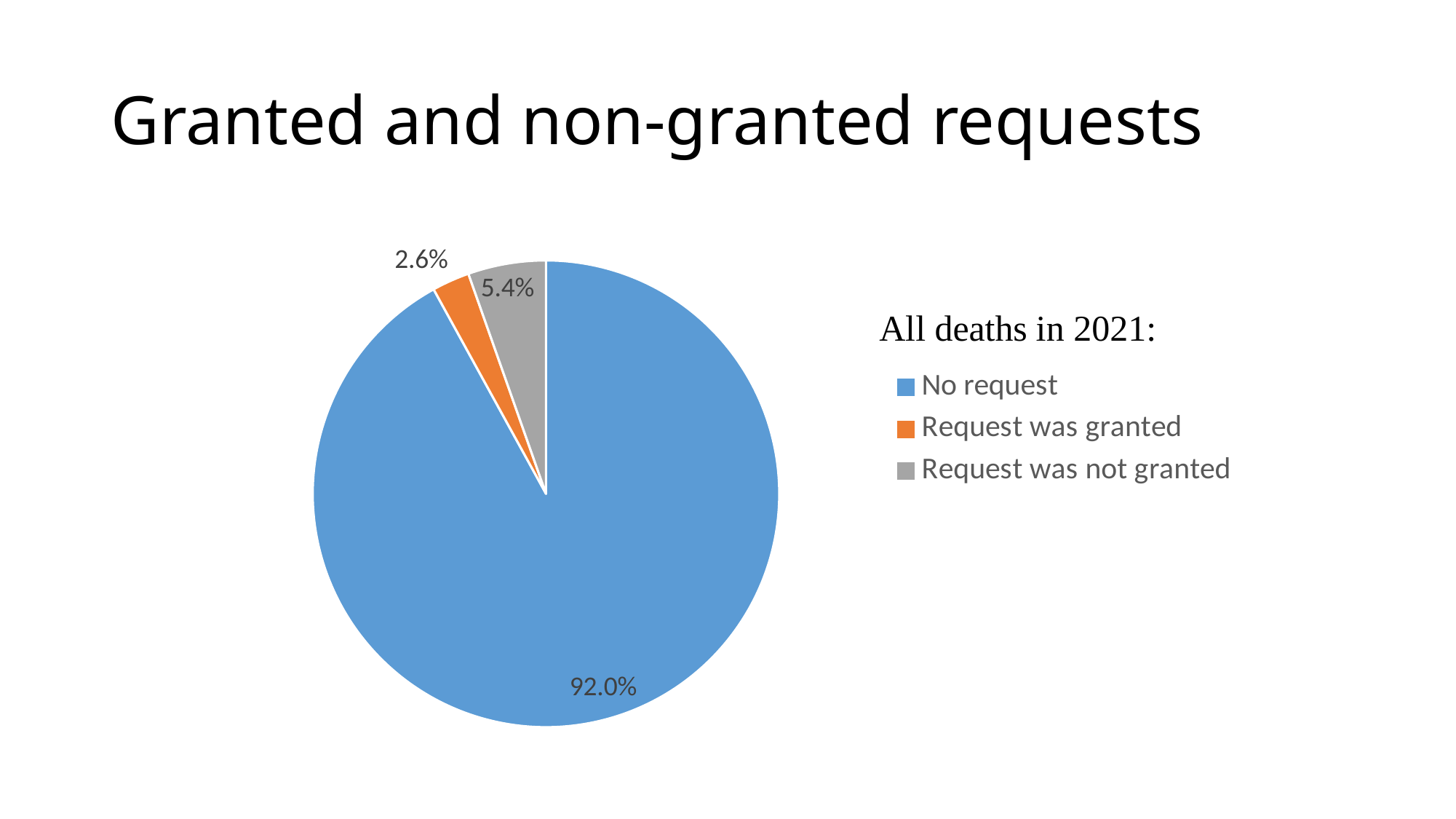
Which category has the largest slice of the pie? No request What is the title of the slide? Granted and non-granted requests What share of the pie is labelled 'Request was granted'? 2.6% What is the difference in percentage points between 'Request was not granted' and 'Request was granted'? 2.8 What colour is the slice for 'Request was granted'? Orange How many entries does the legend list? 3 What kind of chart is shown on the slide? Pie chart Which is larger: the slice for 'Request was granted' or the slice for 'Request was not granted'? Request was not granted Which category has the smallest slice of the pie? Request was granted What share of the pie is labelled 'No request'? 92.0% What share of the pie is labelled 'Request was not granted'? 5.4% How many slices does the pie chart have? 3